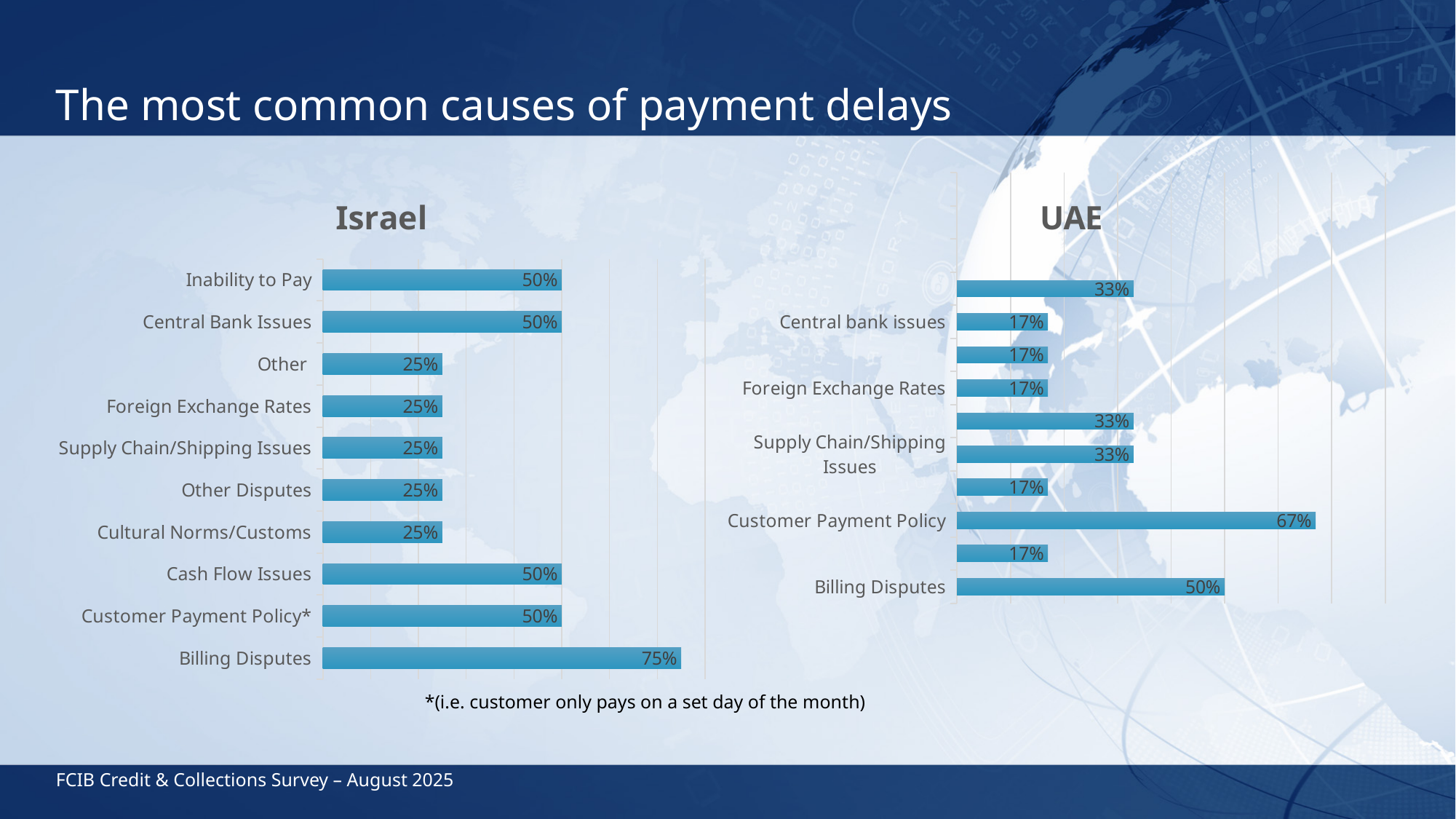
In the Israel chart, how many categories are shown? 10 In the UAE chart, which is larger, Billing Disputes or Supply Chain/Shipping Issues? Billing Disputes In the UAE chart, how many bars are plotted? 10 In the Israel chart, which category has the highest value? Billing Disputes In the UAE chart, what is the value for Central bank issues? 17% In the UAE chart, what is the value for Customer Payment Policy? 67% What is the title of the slide? The most common causes of payment delays What kind of chart is the Israel chart? Bar chart In the UAE chart, what is the difference between Customer Payment Policy and Billing Disputes? 17% In the Israel chart, what is the value for Billing Disputes? 75% In the Israel chart, what is the difference between Billing Disputes and Cash Flow Issues? 25% In the Israel chart, what is the value for Cultural Norms/Customs? 25%